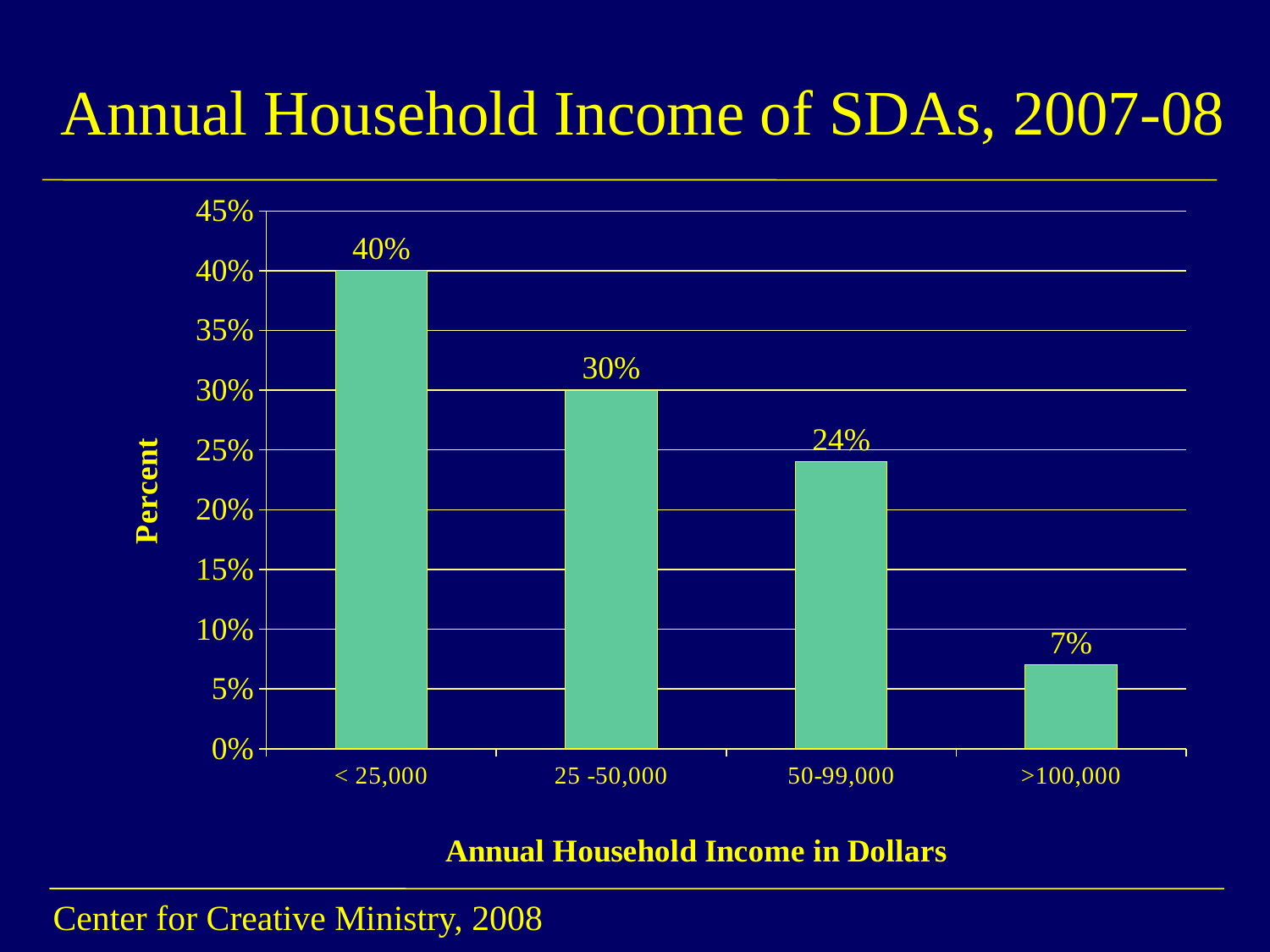
What kind of chart is shown on the slide? Bar chart What percentage of SDA households have an annual income under $25,000? 40% Which income category has the lowest percentage? >100,000 Which is larger, the value for 25-50,000 or the value for 50-99,000? 25-50,000 What is the difference between the 50-99,000 and >100,000 categories? 17% What is the difference in percentage points between the < 25,000 and 25-50,000 categories? 10% How many income categories are shown on the x axis? 4 What is the value for the >100,000 income category? 7% What is the value shown for the 25-50,000 income category? 30% What percentage is shown for the 50-99,000 income category? 24% Which income category has the highest percentage? < 25,000 Do the values rise or fall as income increases along the x axis? Fall